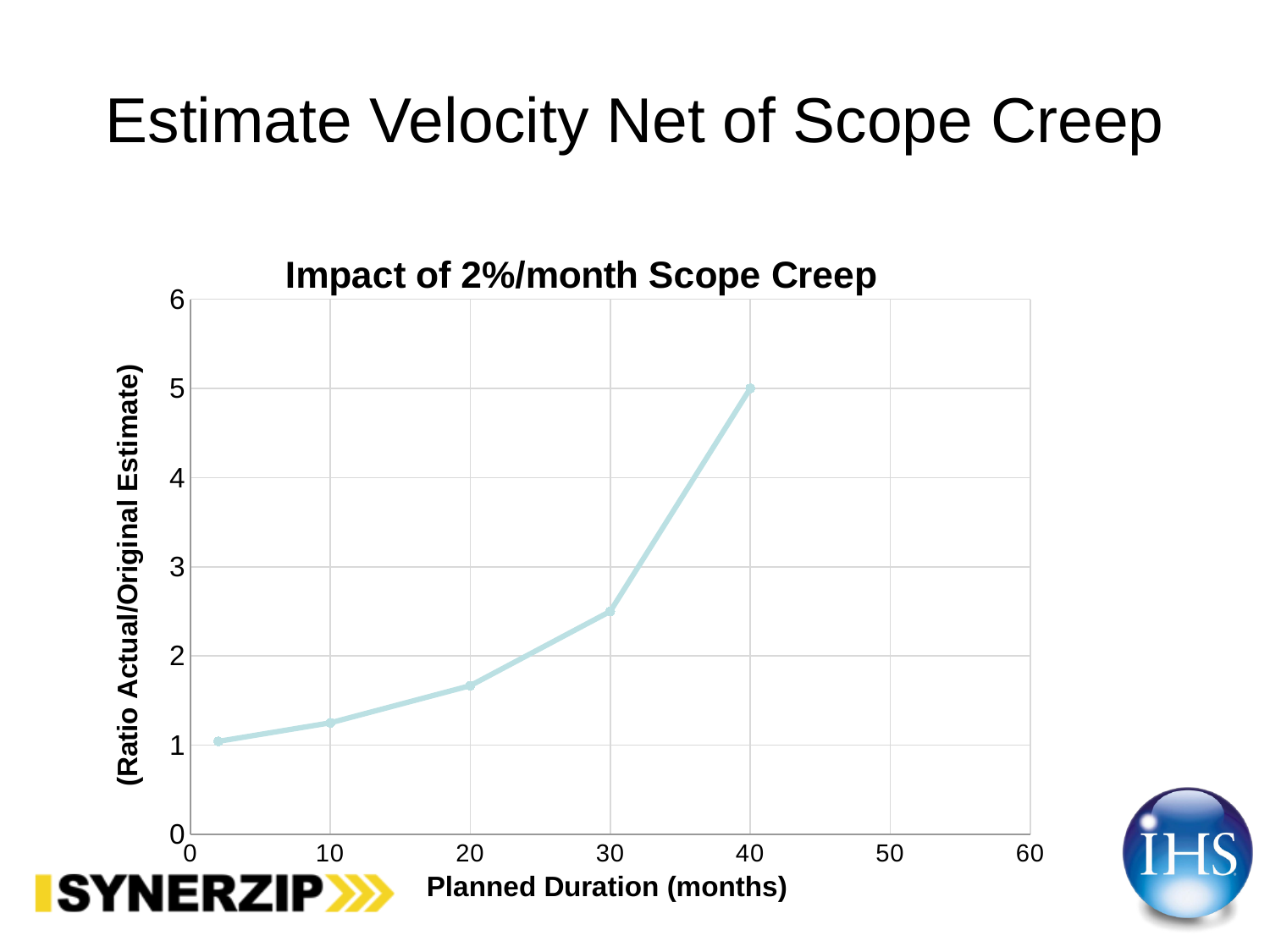
What is the label of the x axis? Planned Duration (months) Is the ratio at a planned duration of 10 months greater or less than 2? less Is the ratio at a planned duration of 20 months greater or less than 2? less What is the ratio of actual to original estimate at a planned duration of 40 months? 5 Is the ratio at a planned duration of 30 months greater or less than 2? greater Does the ratio rise or fall as planned duration increases? Rises What kind of chart is shown on the slide? Line chart At which planned duration is the ratio highest? 40 months What is the title of the chart? Impact of 2%/month Scope Creep How many data points are plotted on the line? 5 Which is larger, the ratio at 30 months or the ratio at 40 months? 40 months